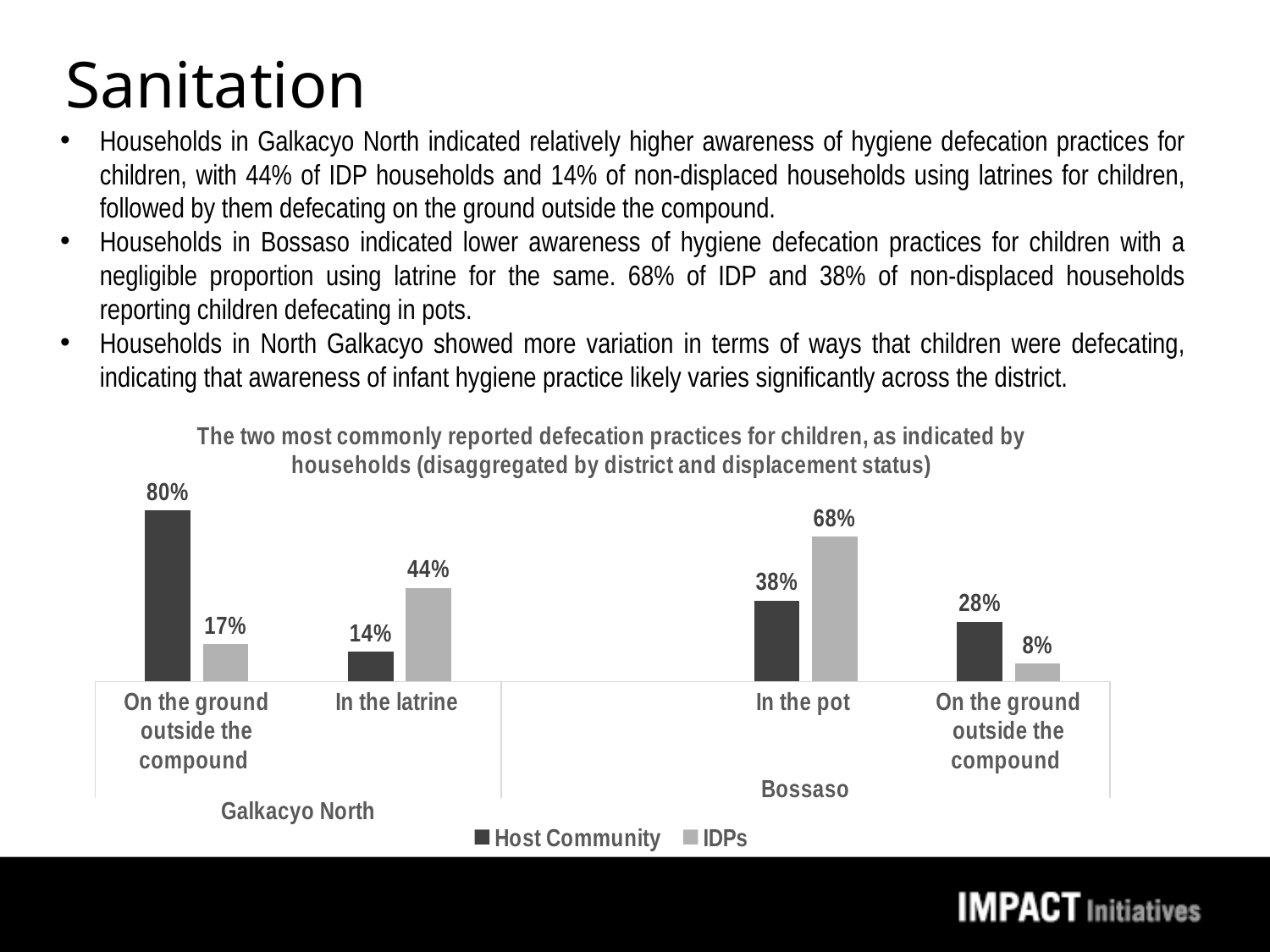
What kind of chart is shown on the slide? Bar chart Which series is shown in the darker colour? Host Community Which category and district has the highest Host Community value? On the ground outside the compound, Galkacyo North What is the Host Community value for 'On the ground outside the compound' in Galkacyo North? 80% For 'In the latrine' in Galkacyo North, which is larger: the Host Community value or the IDPs value? IDPs What is the IDPs value for 'In the pot' in Bossaso? 68% How many categories are shown on the x axis across both districts? 4 Which category and district has the lowest IDPs value? On the ground outside the compound, Bossaso What is the difference between the IDPs and Host Community values for 'In the pot' in Bossaso? 30% What is the IDPs value for 'In the latrine' in Galkacyo North? 44% How many series does the legend list? 2 What is the Host Community value for 'On the ground outside the compound' in Bossaso? 28%